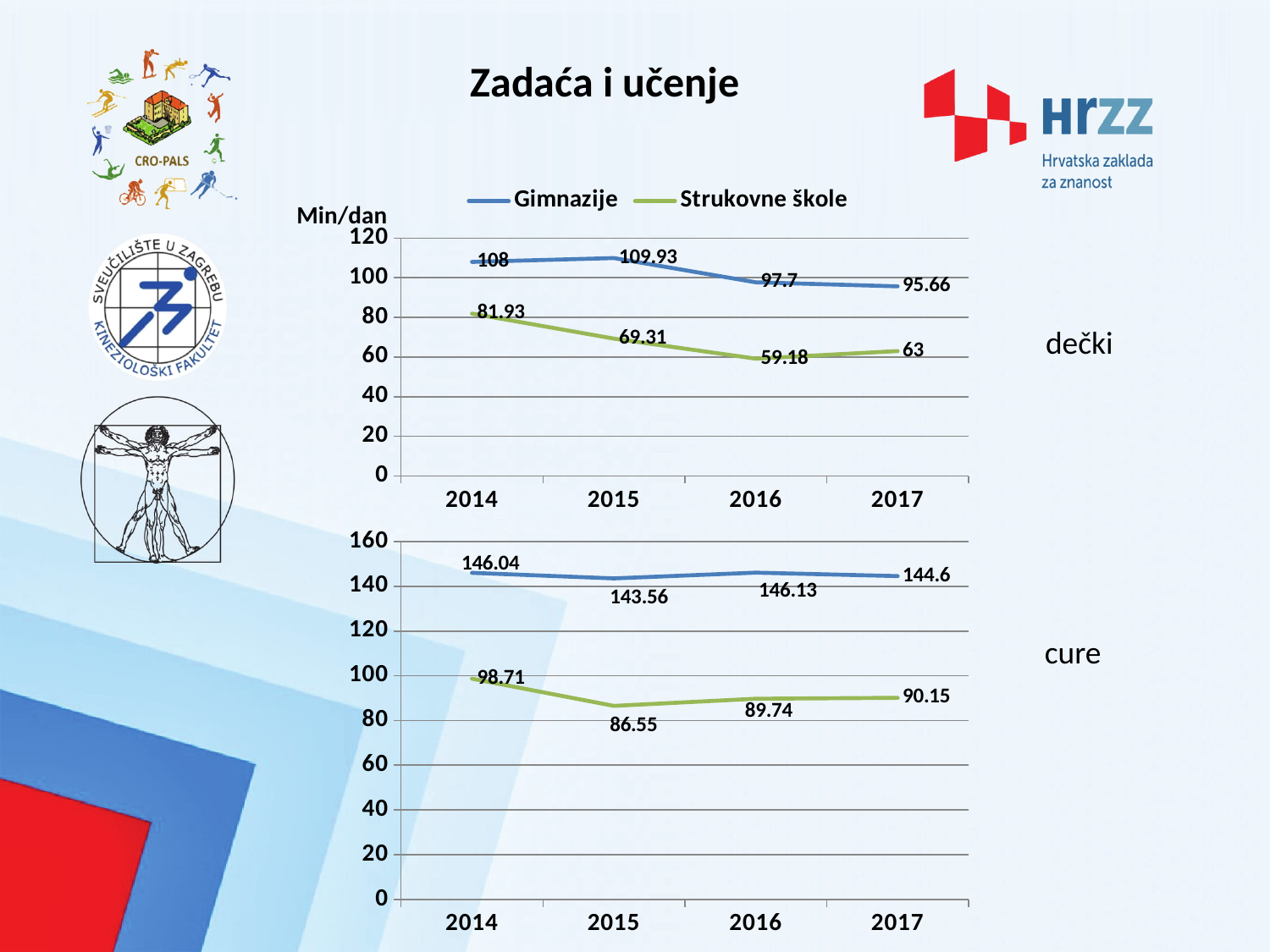
In the top chart (dečki), what is the value for Strukovne škole in 2016? 59.18 In the bottom chart (cure), which year has the lowest value for Strukovne škole? 2015 In the bottom chart (cure), what is the difference between Gimnazije and Strukovne škole in 2017? 54.45 In the bottom chart (cure), what is the value for Strukovne škole in 2017? 90.15 In the top chart (dečki), what is the difference between Gimnazije and Strukovne škole in 2014? 26.07 In the top chart (dečki), what is the value for Gimnazije in 2015? 109.93 How many series does the legend list? 2 In the top chart (dečki), which year has the highest value for Gimnazije? 2015 What kind of chart is the top chart (dečki)? Line chart In the top chart (dečki), which year has the lowest value for Strukovne škole? 2016 In the bottom chart (cure), what is the value for Gimnazije in 2014? 146.04 In the top chart (dečki), which is larger in 2017: Gimnazije or Strukovne škole? Gimnazije